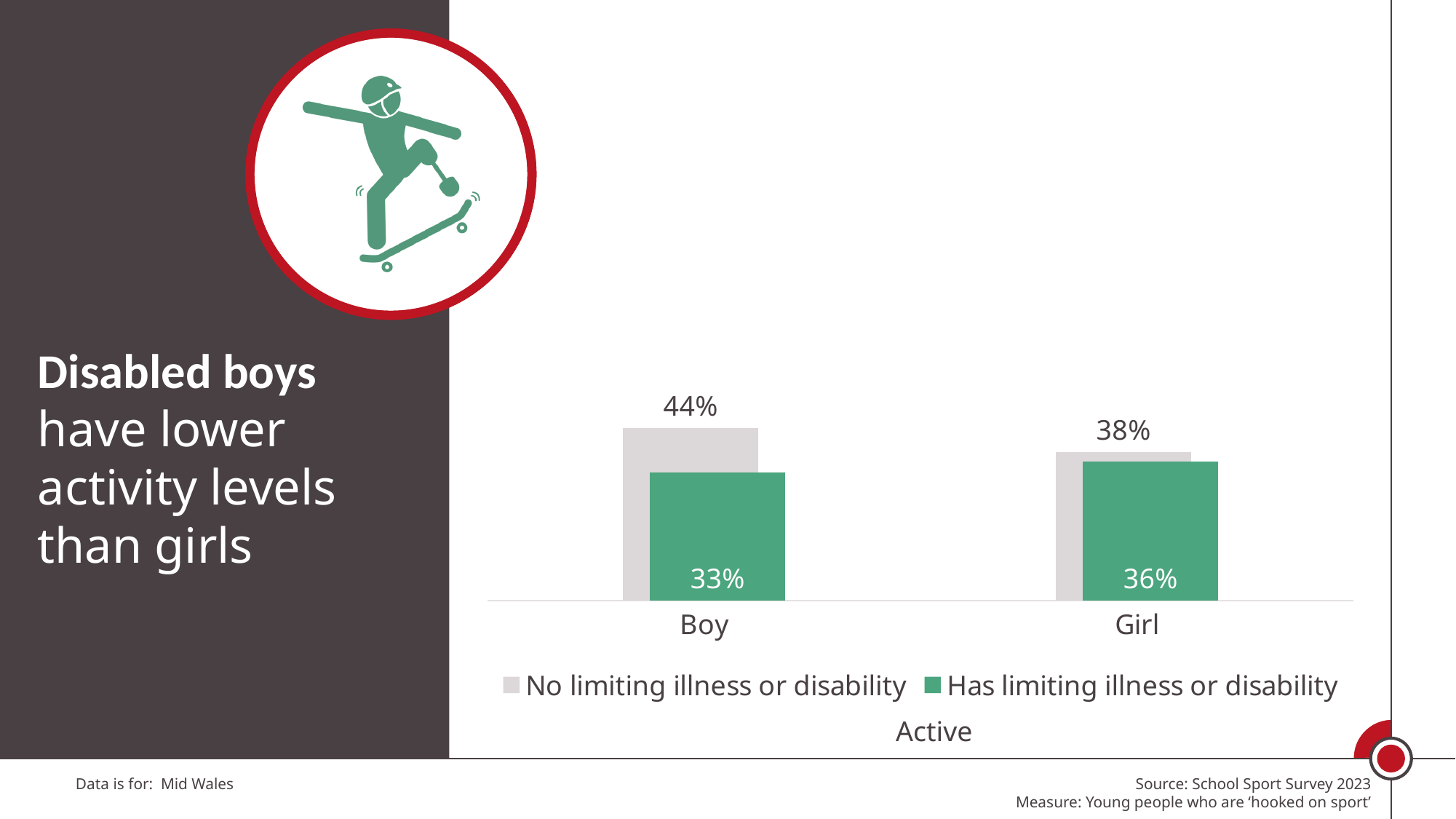
What is the value for girls with no limiting illness or disability? 38% What is the value for boys with no limiting illness or disability? 44% Which is larger: the value for boys with a limiting illness or disability, or the value for girls with a limiting illness or disability? Girls with a limiting illness or disability What is the difference between boys with no limiting illness or disability and boys with a limiting illness or disability? 11 percentage points Which group has the lowest value on the chart? Boys with a limiting illness or disability What kind of chart is shown on the slide? Bar chart How many series does the legend list? 2 What is the value for boys who have a limiting illness or disability? 33% What is the value for girls who have a limiting illness or disability? 36% Which group has the highest value on the chart? Boys with no limiting illness or disability How many categories are shown on the x axis? 2 What is the difference between girls with no limiting illness or disability and girls with a limiting illness or disability? 2 percentage points